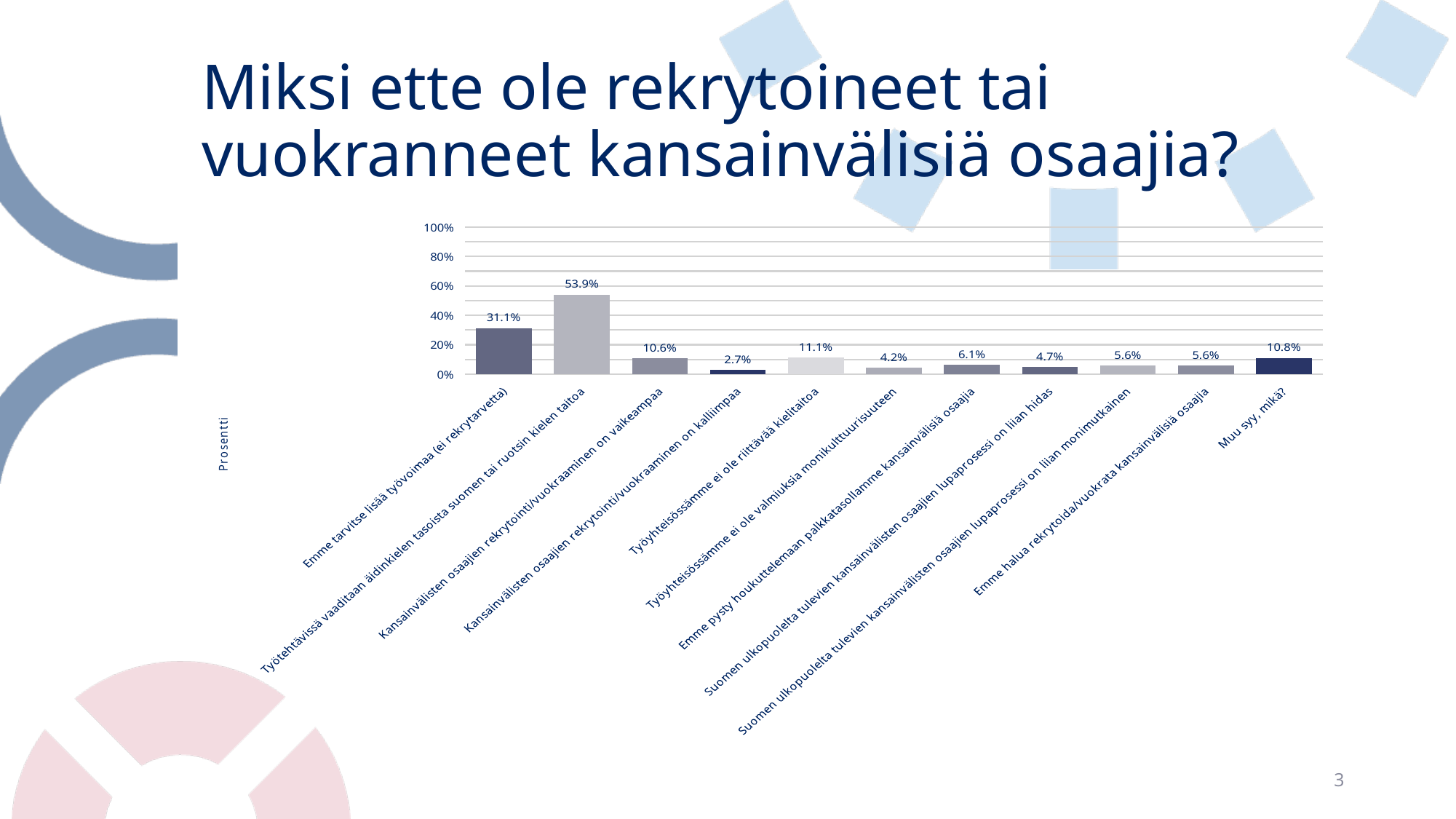
Which category has the lowest value? Kansainvälisten osaajien rekrytointi/vuokraaminen on kalliimpaa Which category has the highest value? Työtehtävissä vaaditaan äidinkielen tasoista suomen tai ruotsin kielen taitoa What is the value for "Emme tarvitse lisää työvoimaa (ei rekrytarvetta)"? 31.1% What is the label of the vertical axis? Prosentti What kind of chart is shown on the slide? bar chart Which is larger: the value for "Kansainvälisten osaajien rekrytointi/vuokraaminen on vaikeampaa" or for "Emme pysty houkuttelemaan palkkatasollamme kansainvälisiä osaajia"? Kansainvälisten osaajien rekrytointi/vuokraaminen on vaikeampaa Is the value for "Työtehtävissä vaaditaan äidinkielen tasoista suomen tai ruotsin kielen taitoa" greater or less than 40%? greater What is the value for "Suomen ulkopuolelta tulevien kansainvälisten osaajien lupaprosessi on liian hidas"? 4.7% What is the value for "Muu syy, mikä?"? 10.8% What is the value for "Työyhteisössämme ei ole riittävää kielitaitoa"? 11.1% How many categories are shown on the x axis? 11 What is the difference between the values for "Työtehtävissä vaaditaan äidinkielen tasoista suomen tai ruotsin kielen taitoa" and "Emme tarvitse lisää työvoimaa (ei rekrytarvetta)"? 22.8%